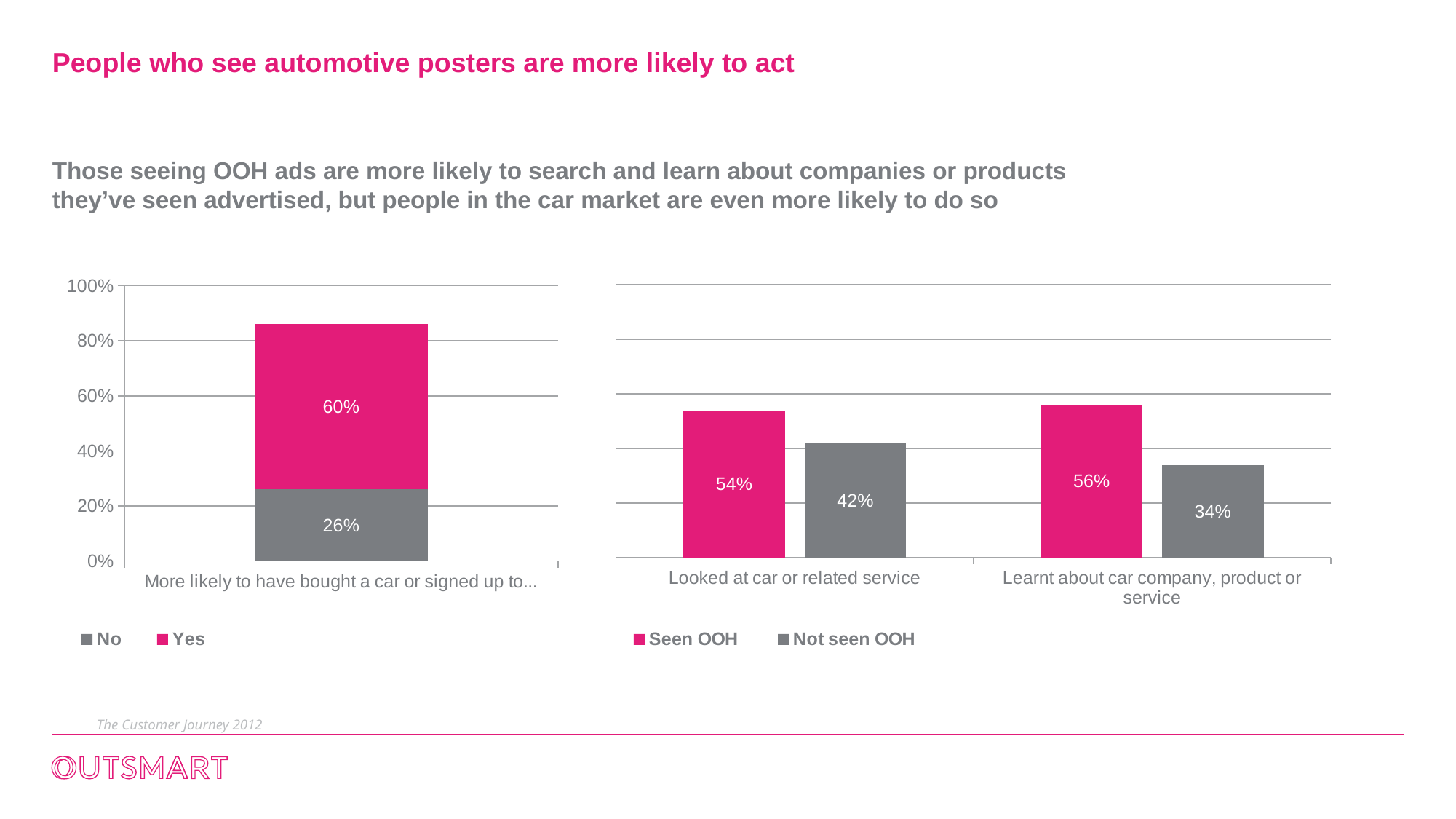
In the right chart, what colour represents "Seen OOH"? Pink In the right chart, which is larger for "Looked at car or related service": "Seen OOH" or "Not seen OOH"? Seen OOH In the left chart, what is the value for "Yes"? 60% In the left chart, how many series does the legend list? 2 In the right chart, how many categories are shown on the x axis? 2 In the right chart, what is the difference between "Seen OOH" and "Not seen OOH" for "Learnt about car company, product or service"? 22% In the right chart, which category has the lowest "Not seen OOH" value? Learnt about car company, product or service In the left chart, what is the value for "No"? 26% What kind of chart is the right chart? Bar chart In the right chart, what is the value for "Seen OOH" in "Looked at car or related service"? 54% In the right chart, what is the value for "Not seen OOH" in "Learnt about car company, product or service"? 34% In the left chart, what is the total of the stacked bar? 86%